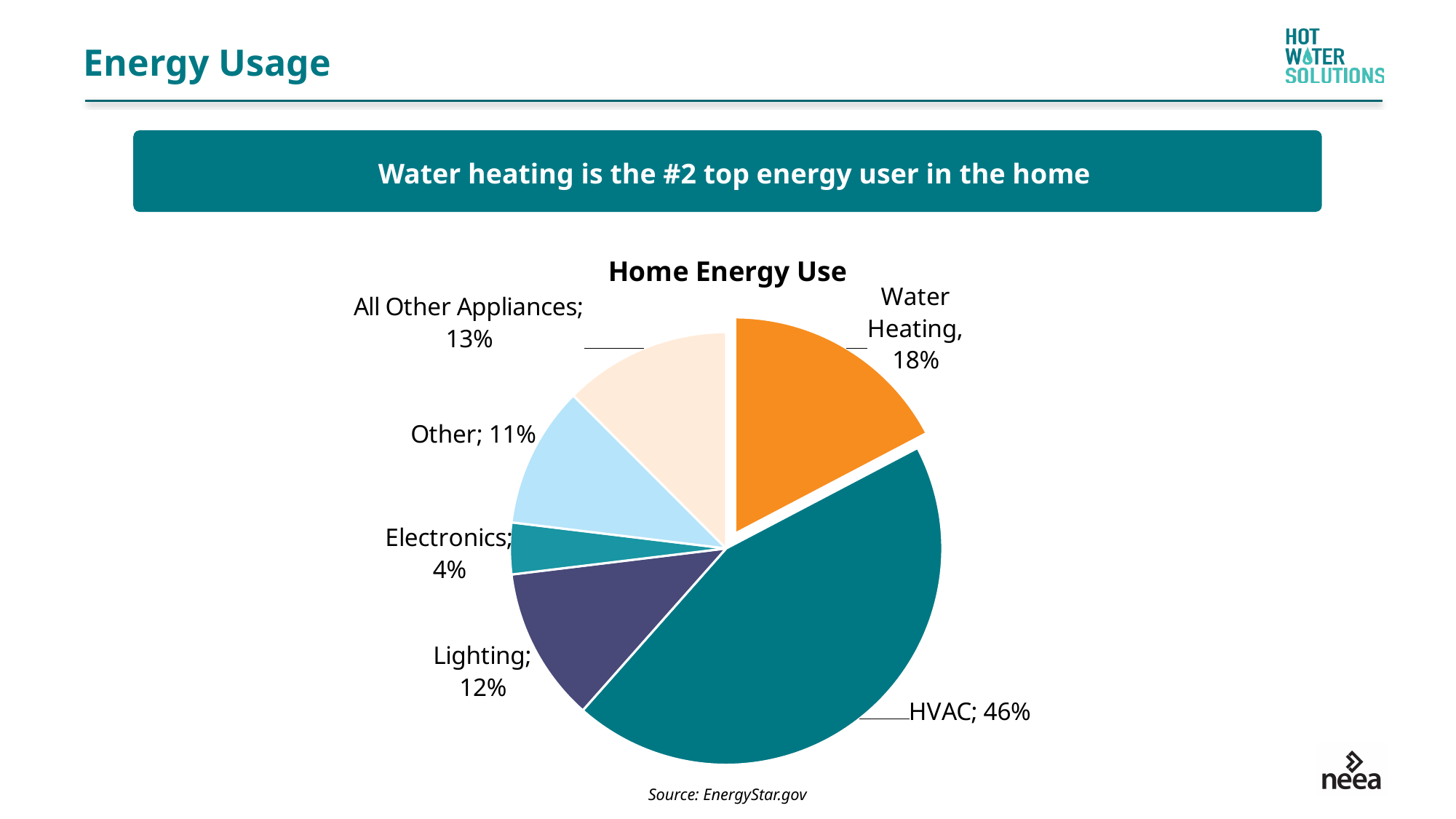
What is the difference between the HVAC share and the Water Heating share? 28% What share of home energy use is Water Heating? 18% What is the title of the chart? Home Energy Use What share of home energy use is Electronics? 4% What share of home energy use is Lighting? 12% Which category has the largest share of home energy use? HVAC What kind of chart is shown on the slide? Pie chart What share of home energy use is HVAC? 46% What share of home energy use is All Other Appliances? 13% Which category has the smallest share of home energy use? Electronics Which is larger, the share for Other or the share for Lighting? Lighting How many categories are shown in the pie chart? 6